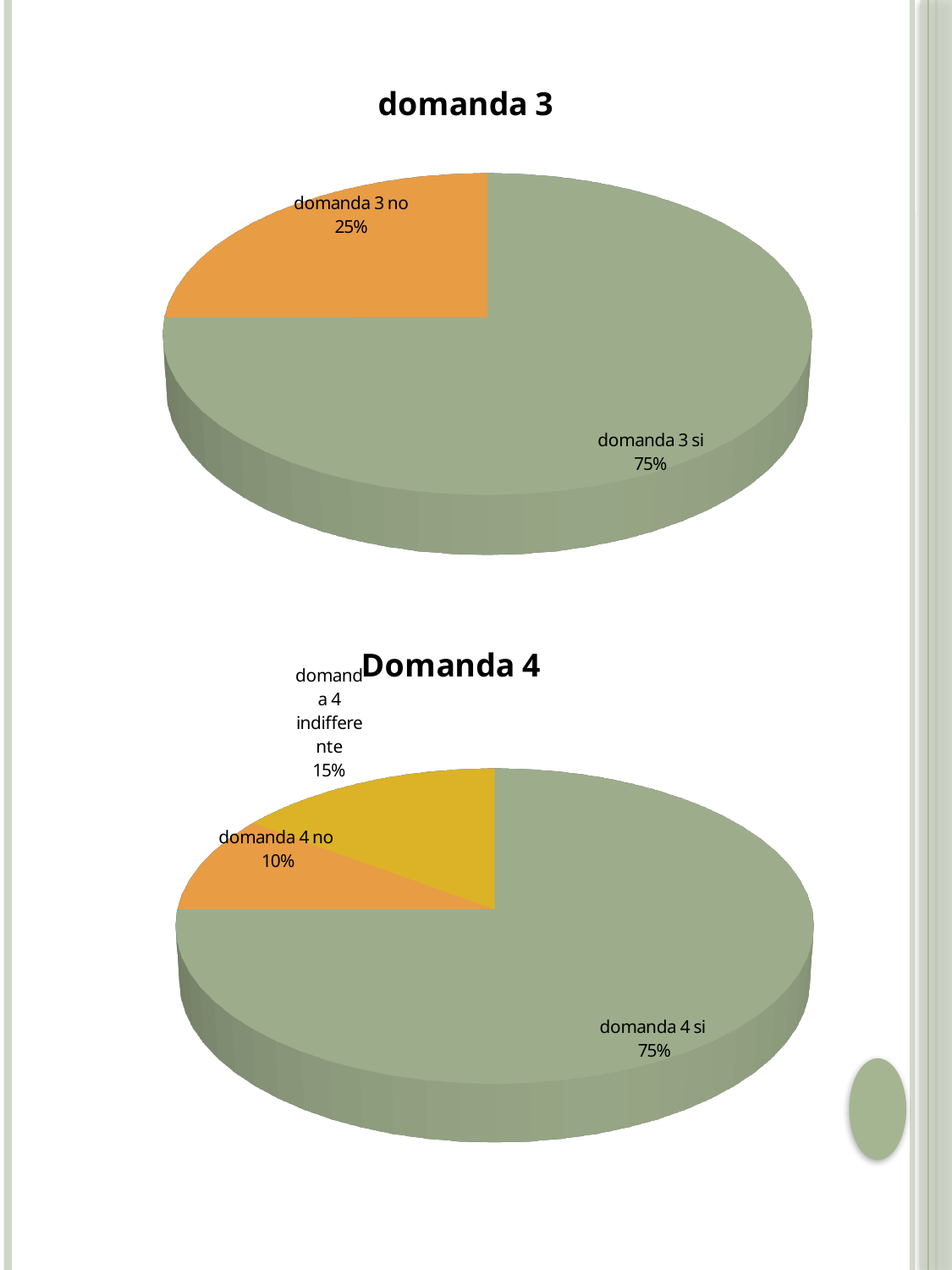
In the "domanda 3" chart, what is the difference in percentage points between "domanda 3 si" and "domanda 3 no"? 50 percentage points In the "Domanda 4" chart, which is larger: "domanda 4 indifferente" or "domanda 4 no"? domanda 4 indifferente In the "domanda 3" chart, what share does "domanda 3 no" have? 25% In the "domanda 3" chart, how many slices are there? 2 In the "Domanda 4" chart, which slice is the smallest? domanda 4 no What kind of chart is the "domanda 3" chart? Pie chart What is the title of the bottom chart on the slide? Domanda 4 In the "domanda 3" chart, what share does "domanda 3 si" have? 75% In the "Domanda 4" chart, how many slices are there? 3 In the "Domanda 4" chart, what share does "domanda 4 indifferente" have? 15% In the "domanda 3" chart, which slice is the largest? domanda 3 si